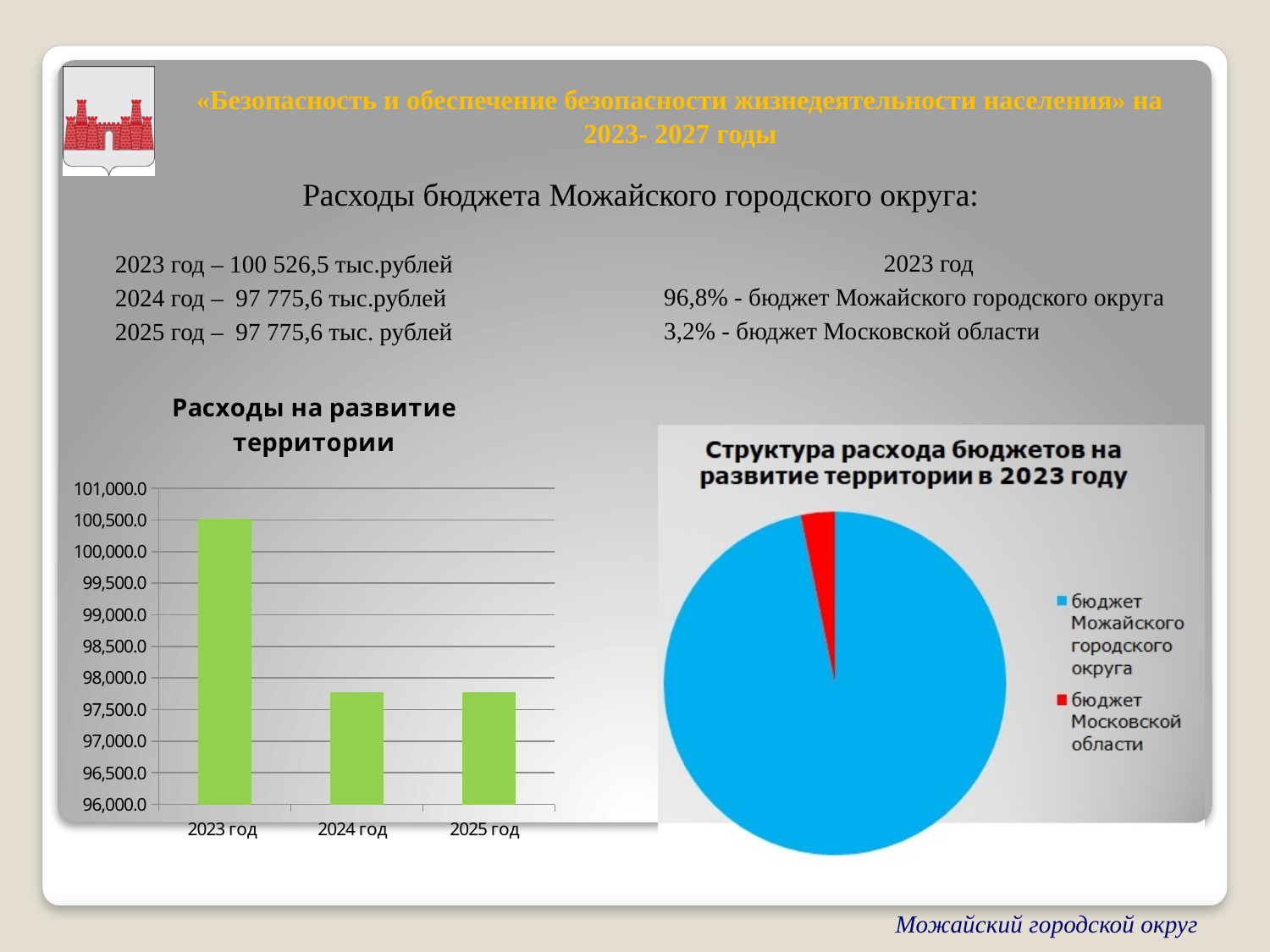
In the bar chart "Расходы на развитие территории", which year has the highest value? 2023 год In the bar chart "Расходы на развитие территории", is the value for 2024 год greater or less than 99,000.0? less In the pie chart "Структура расхода бюджетов на развитие территории в 2023 году", what share does "бюджет Московской области" have? 3,2% In the pie chart "Структура расхода бюджетов на развитие территории в 2023 году", what colour is the slice for "бюджет Можайского городского округа"? blue What type of chart is the chart titled "Структура расхода бюджетов на развитие территории в 2023 году"? pie chart In the pie chart "Структура расхода бюджетов на развитие территории в 2023 году", how many entries does the legend list? 2 In the bar chart "Расходы на развитие территории", does the value rise or fall from 2023 год to 2024 год? fall In the bar chart "Расходы на развитие территории", which is larger, the value for 2023 год or the value for 2024 год? 2023 год According to the slide, what is the budget expenditure for 2023 год shown in the bar chart "Расходы на развитие территории"? 100 526,5 тыс.рублей What type of chart is the chart titled "Расходы на развитие территории"? bar chart In the bar chart "Расходы на развитие территории", is the value for 2023 год greater or less than 100,000.0? greater In the bar chart "Расходы на развитие территории", how many years are shown on the x axis? 3